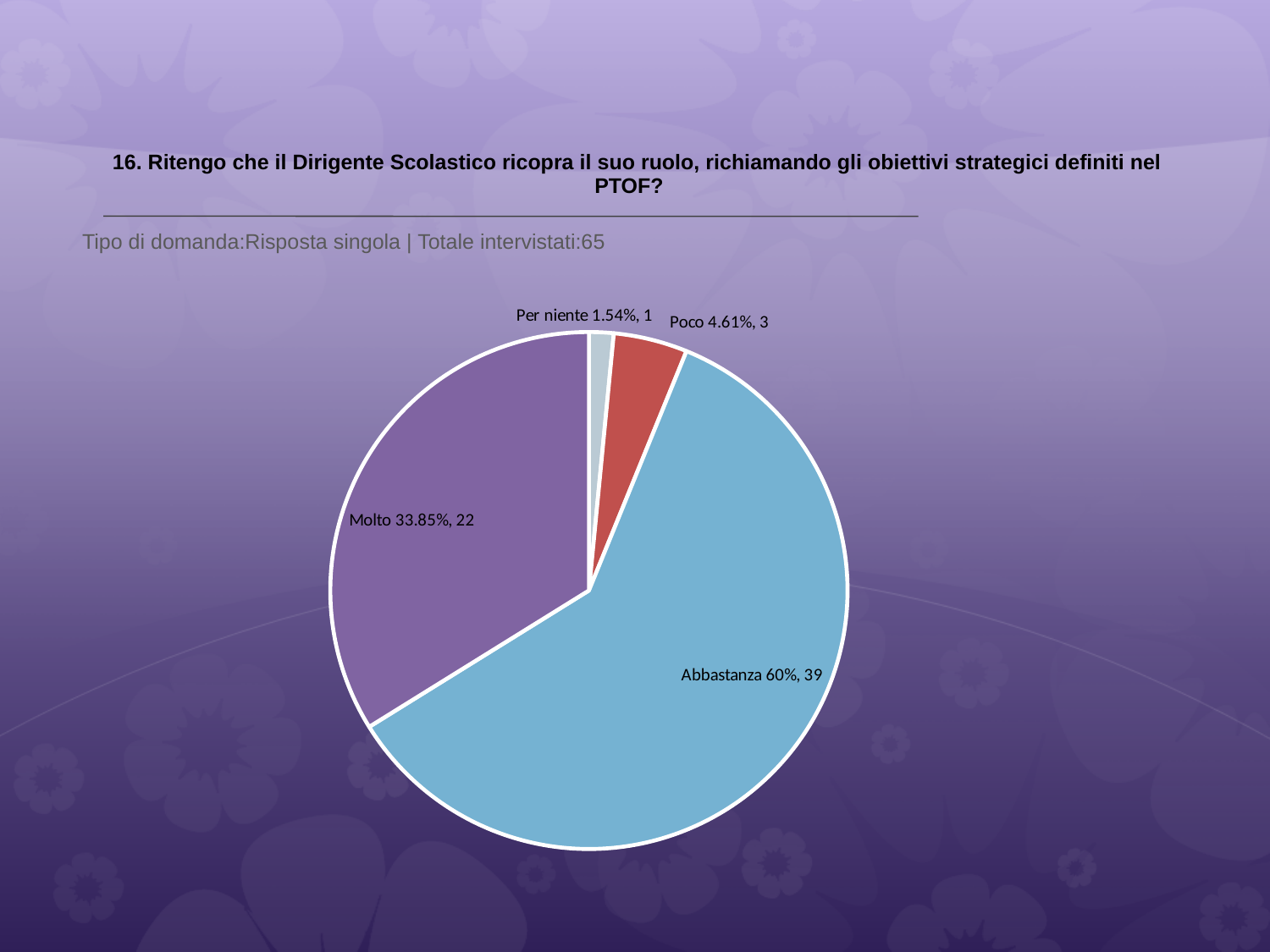
Which category has the largest slice? Abbastanza How many slices does the pie chart have? 4 What is the count for the 'Abbastanza' slice? 39 What percentage share does the 'Per niente' slice represent? 1.54% What colour is the 'Abbastanza' slice? light blue What percentage share does the 'Molto' slice represent? 33.85% What kind of chart is shown on the slide? pie chart Which category has the smallest slice? Per niente What is the total number of respondents across all slices? 65 What is the difference in count between 'Abbastanza' and 'Molto'? 17 What is the count for the 'Poco' slice? 3 Which is larger, the 'Poco' slice or the 'Per niente' slice? Poco